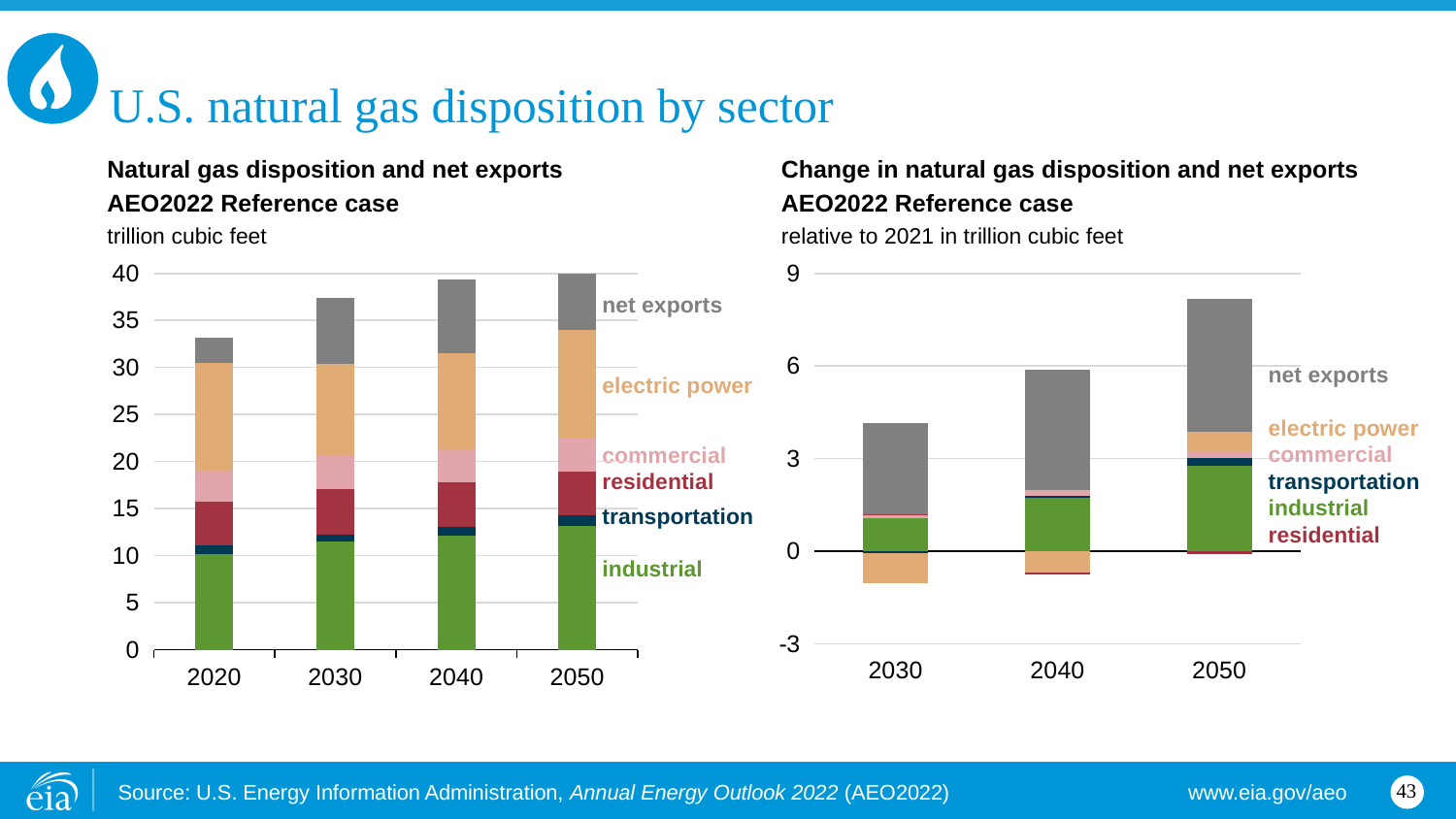
How many years are shown on the x axis of the right chart, 'Change in natural gas disposition and net exports'? 3 In the left chart, 'Natural gas disposition and net exports', which year has the lowest total bar? 2020 In the left chart, 'Natural gas disposition and net exports', is the total bar for 2020 greater or less than 30? greater In the left chart, 'Natural gas disposition and net exports', is the total bar for 2050 greater or less than 35? greater In the left chart, 'Natural gas disposition and net exports', which sector is the largest segment of the 2020 bar: industrial or electric power? electric power In the right chart, 'Change in natural gas disposition and net exports', is the total positive bar for 2050 greater or less than 6? greater In the right chart, 'Change in natural gas disposition and net exports', which year has the smallest positive stacked bar? 2030 What kind of chart is the left chart, 'Natural gas disposition and net exports'? stacked bar chart How many years are shown on the x axis of the left chart, 'Natural gas disposition and net exports'? 4 How many sectors/series are labeled in the left chart, 'Natural gas disposition and net exports'? 6 What unit is used on the left chart, 'Natural gas disposition and net exports'? trillion cubic feet In the left chart, 'Natural gas disposition and net exports', do the total bars rise or fall from 2020 to 2050? rise